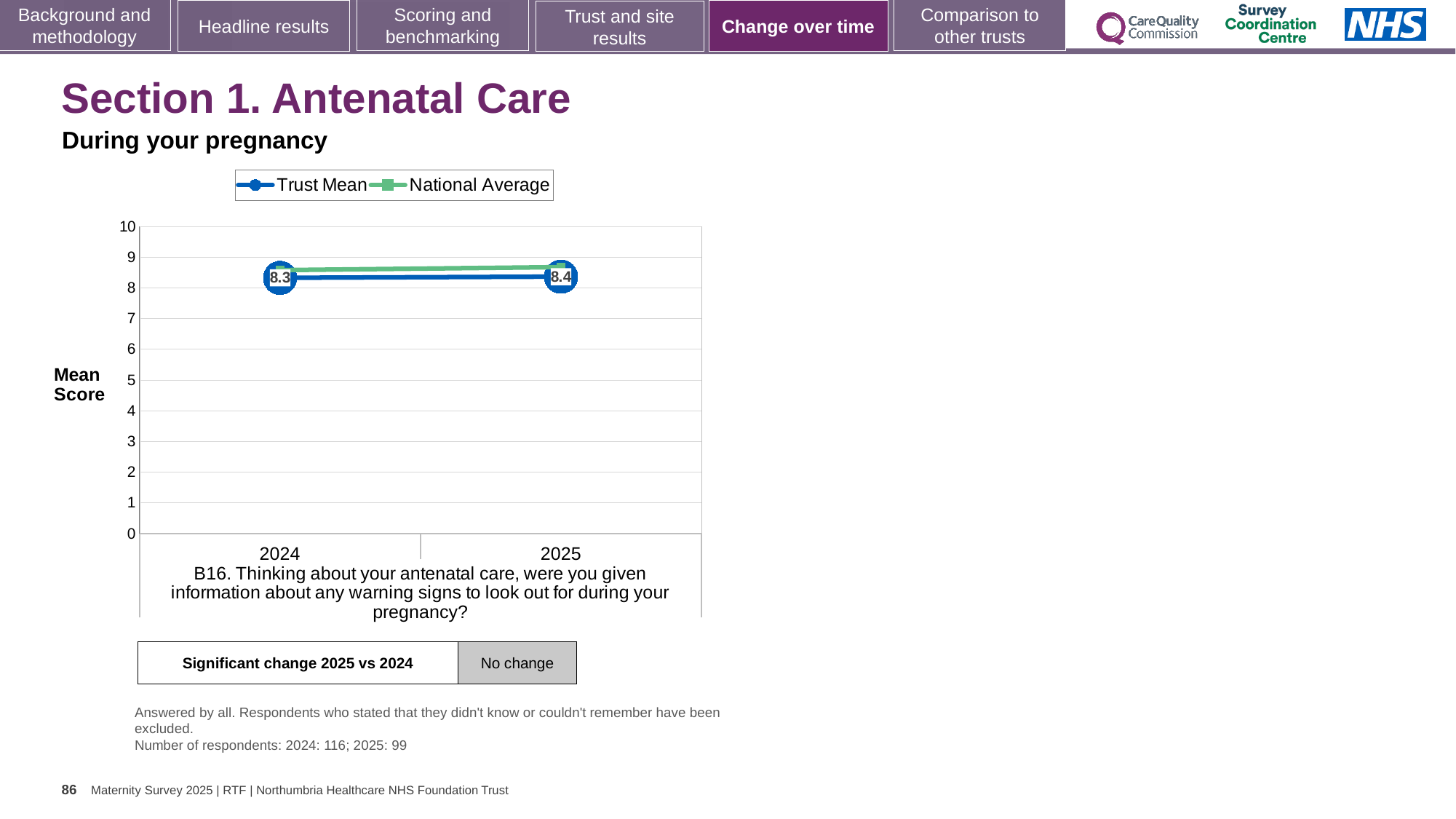
What is the difference between the Trust Mean in 2025 and in 2024? 0.1 What is the Trust Mean value for 2024? 8.3 Is the National Average value for 2025 greater or less than 9? less Is the National Average value for 2024 greater or less than 8? greater Does the Trust Mean rise or fall from 2024 to 2025? rise Which year has the higher Trust Mean, 2024 or 2025? 2025 What is the label on the y axis of the chart? Mean Score In 2024, which is higher, the Trust Mean or the National Average? National Average What kind of chart is shown on the slide? line chart What is the Trust Mean value for 2025? 8.4 How many years are shown on the x axis of the chart? 2 How many series does the chart legend list? 2